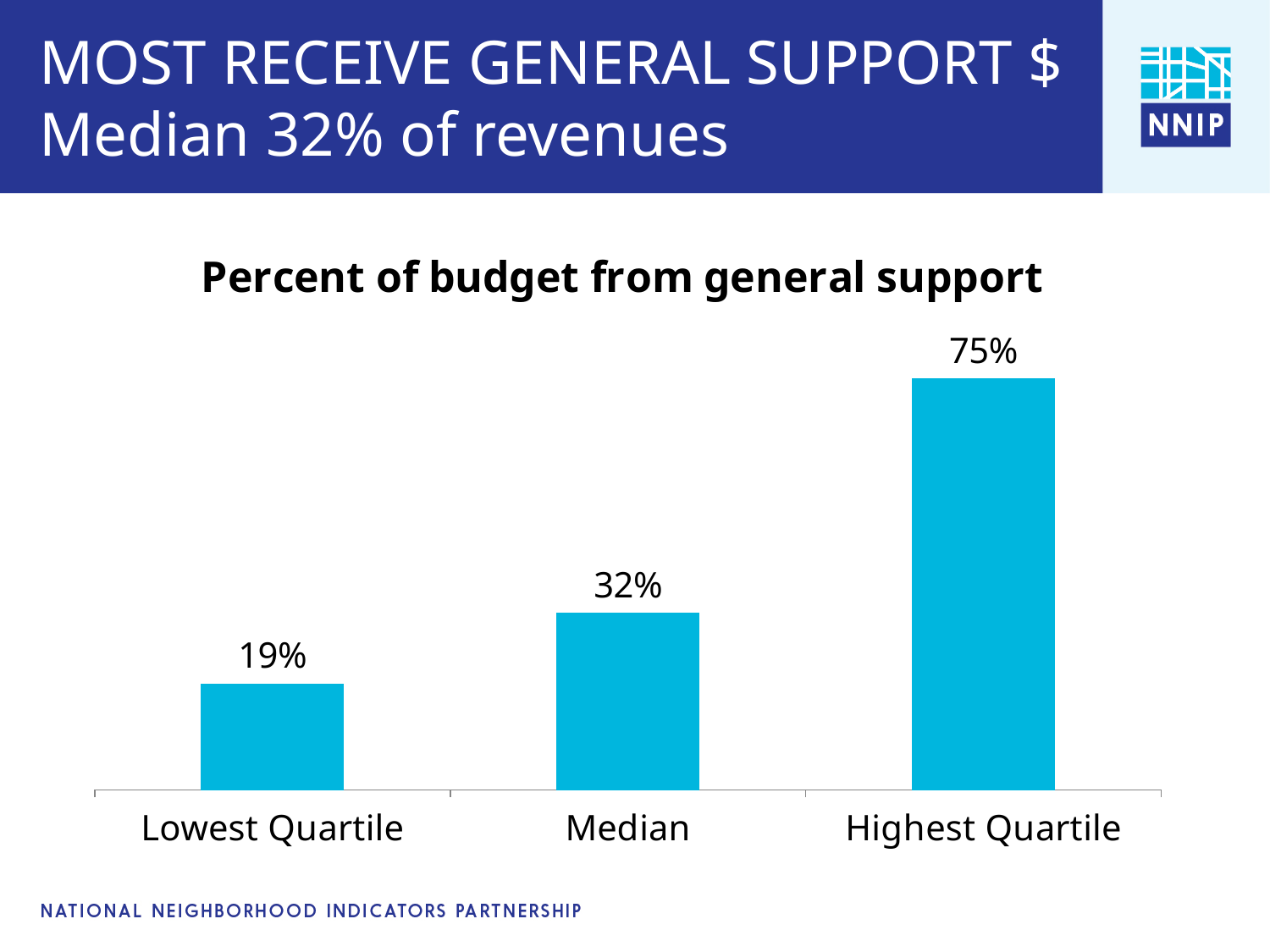
What is the value for Highest Quartile? 75% What is the difference between the Median and the Lowest Quartile values? 13% Do the values rise or fall from left to right along the x axis? Rise Which is larger, the value for Median or the value for Highest Quartile? Highest Quartile What kind of chart is shown? Bar chart What is the title of the chart? Percent of budget from general support Which category has the lowest value? Lowest Quartile What is the value for Median? 32% What is the value for Lowest Quartile? 19% How many categories are shown on the x axis? 3 Which category has the highest value? Highest Quartile What is the difference between the Highest Quartile and the Lowest Quartile values? 56%